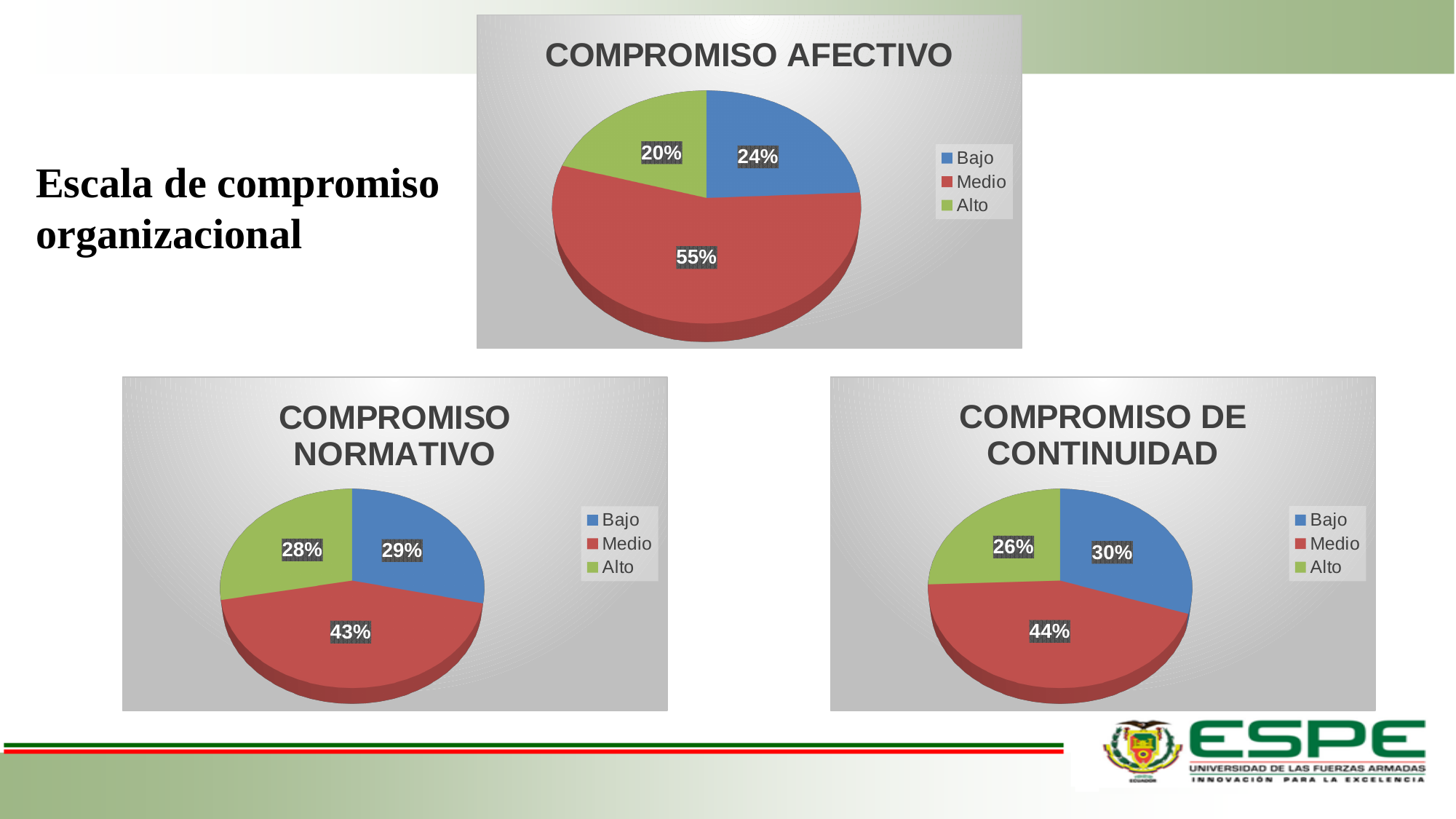
How many charts are shown on the slide? 3 In the COMPROMISO AFECTIVO chart, what is the difference between the Medio and Bajo shares? 31% In the COMPROMISO DE CONTINUIDAD chart, what percentage is shown for Medio? 44% In the COMPROMISO NORMATIVO chart, which category has the smallest share? Alto What type of chart is the COMPROMISO NORMATIVO chart? Pie chart In the COMPROMISO AFECTIVO chart, which category has the largest share? Medio In the COMPROMISO NORMATIVO chart, what percentage is shown for Bajo? 29% In the COMPROMISO AFECTIVO chart, what percentage is shown for Medio? 55% In the COMPROMISO AFECTIVO chart, what percentage is shown for Alto? 20% In the COMPROMISO DE CONTINUIDAD chart, which category has the smallest share? Alto How many categories does the legend of the COMPROMISO DE CONTINUIDAD chart list? 3 In the COMPROMISO DE CONTINUIDAD chart, which is larger, Bajo or Alto? Bajo